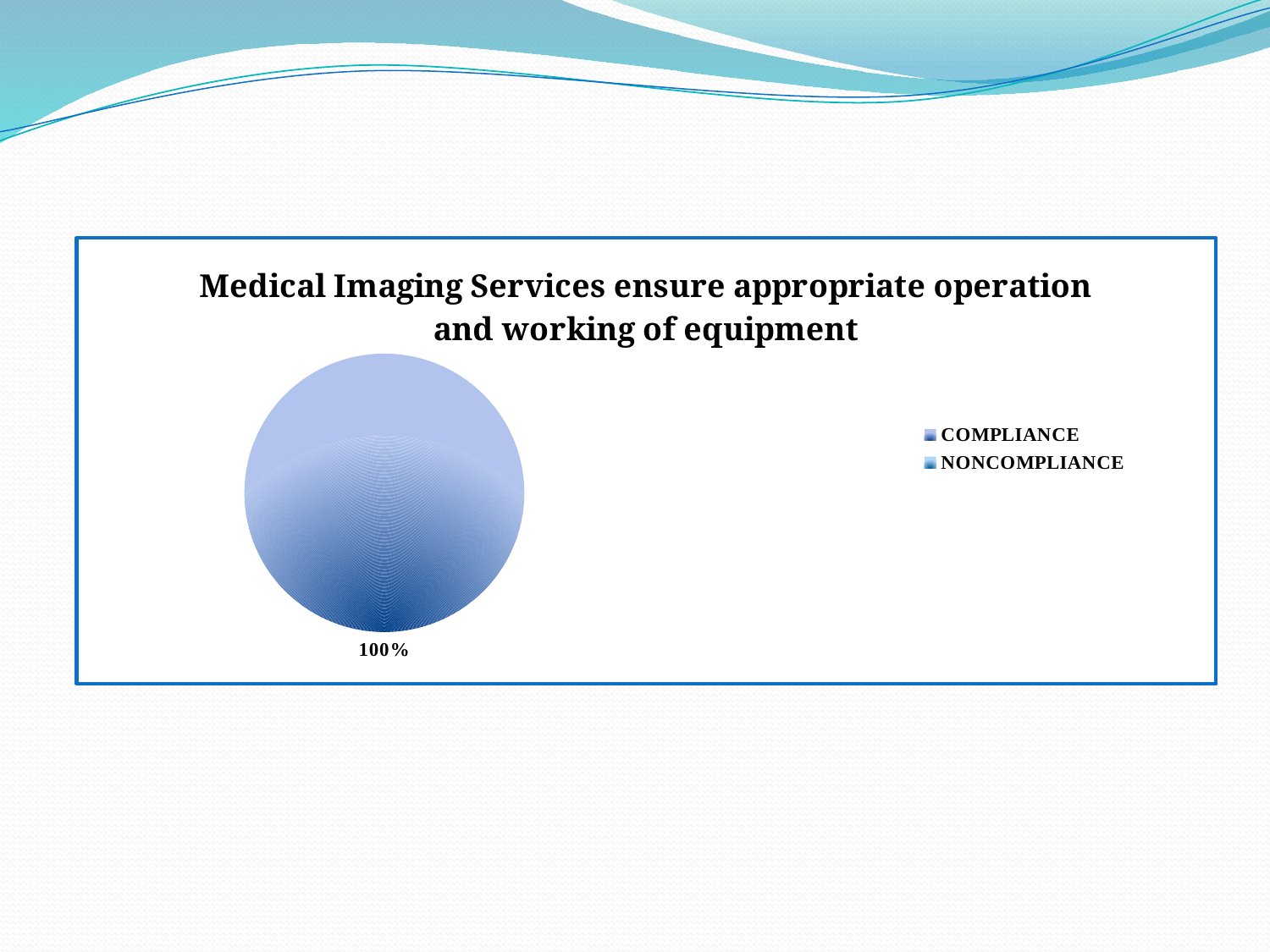
How many slices are visible in the pie? 1 Is the value shown on the pie greater or less than 50%? greater What percentage value is printed as the data label on the pie? 100% What kind of chart is shown on the slide? pie chart What share of the pie does the single visible slice take up? 100% How many entries does the chart's legend list? 2 What are the two categories listed in the legend? COMPLIANCE and NONCOMPLIANCE What is the title of the chart? Medical Imaging Services ensure appropriate operation and working of equipment